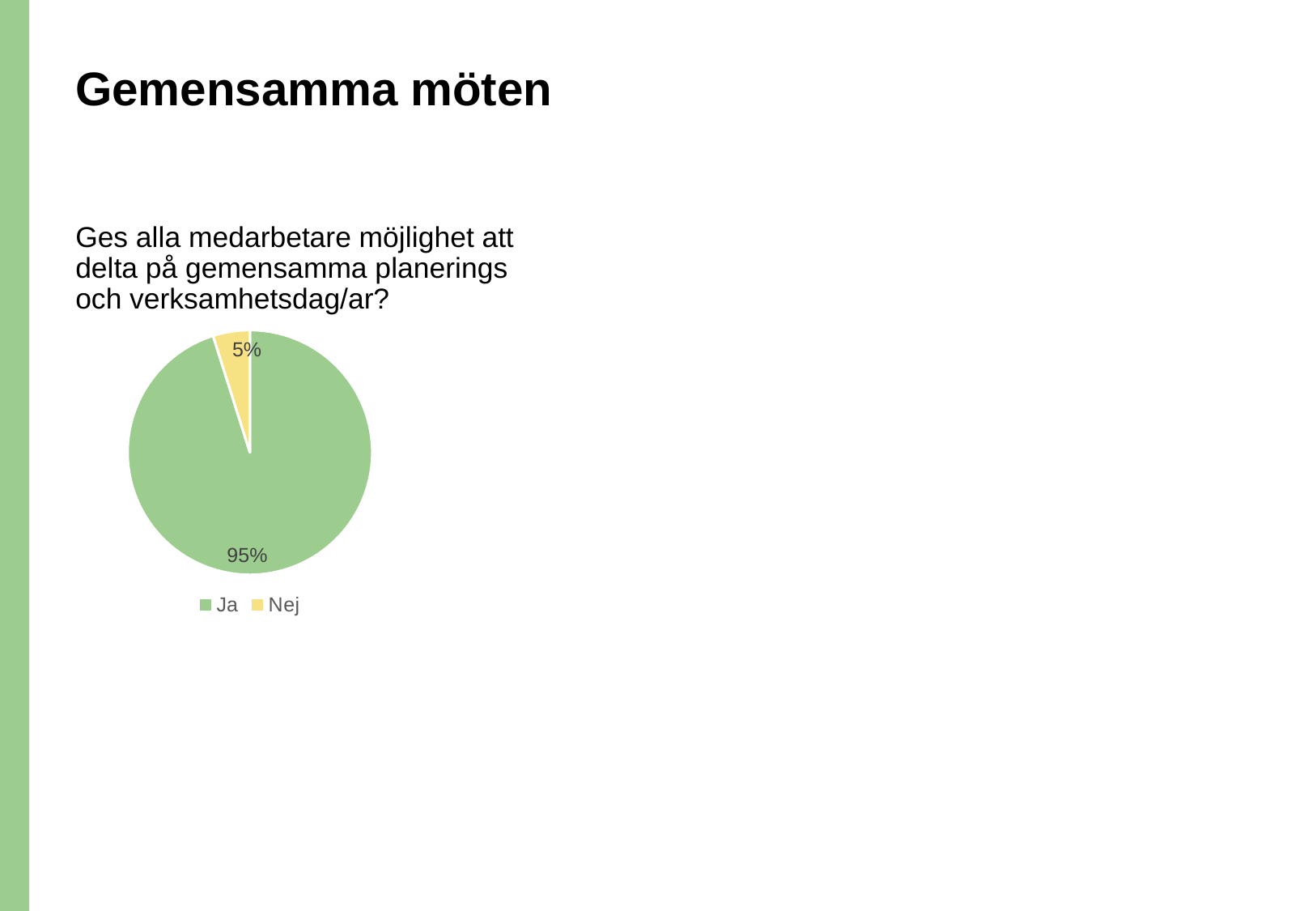
What is the difference in percentage points between the "Ja" and "Nej" slices? 90 Which is larger, the "Ja" slice or the "Nej" slice? Ja Which category has the smallest slice of the pie? Nej What share of the pie does "Nej" represent? 5% How many categories are shown in the pie chart? 2 What colour is the "Ja" slice? Green How many entries does the legend list? 2 What kind of chart is shown on the slide? Pie chart What share of the pie does "Ja" represent? 95% Which category has the largest slice of the pie? Ja What colour is the "Nej" slice? Yellow